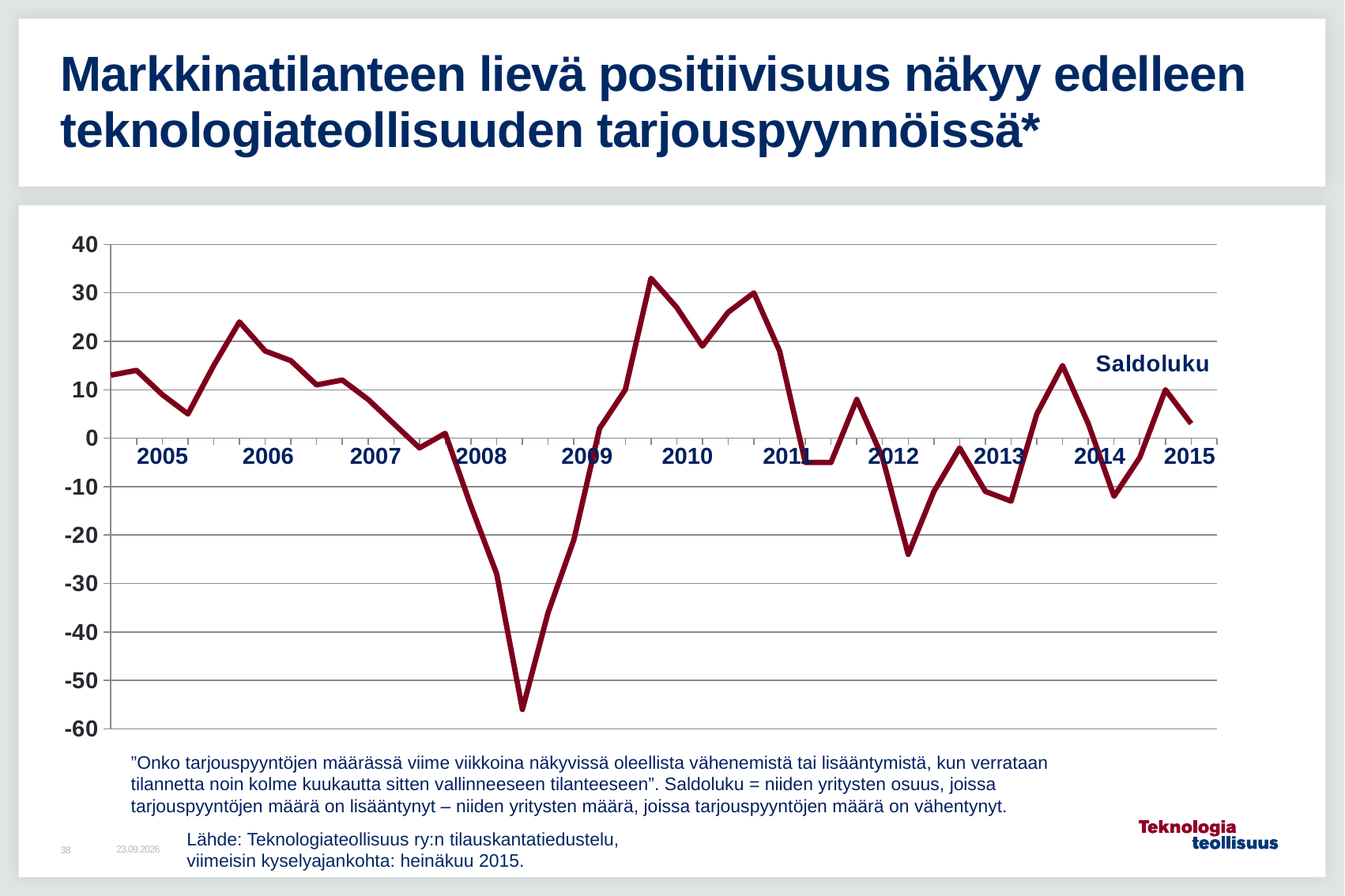
What kind of chart is shown on the slide? line chart What is the name of the series plotted in the chart? Saldoluku Is the last value of the Saldoluku line in 2015 greater or less than 10? less Is the highest point of the Saldoluku line greater or less than 30? greater Is the value of the Saldoluku line at the start of 2005 greater or less than 10? greater How many years are labelled on the x axis of the chart? 11 Which is larger: the lowest point of the line in 2012 or the lowest point of the line in 2008? 2012 From the start of 2008 to the lowest point of the line, does the Saldoluku value rise or fall? fall What is the highest value shown on the y axis of the chart? 40 How many data series does the chart plot? 1